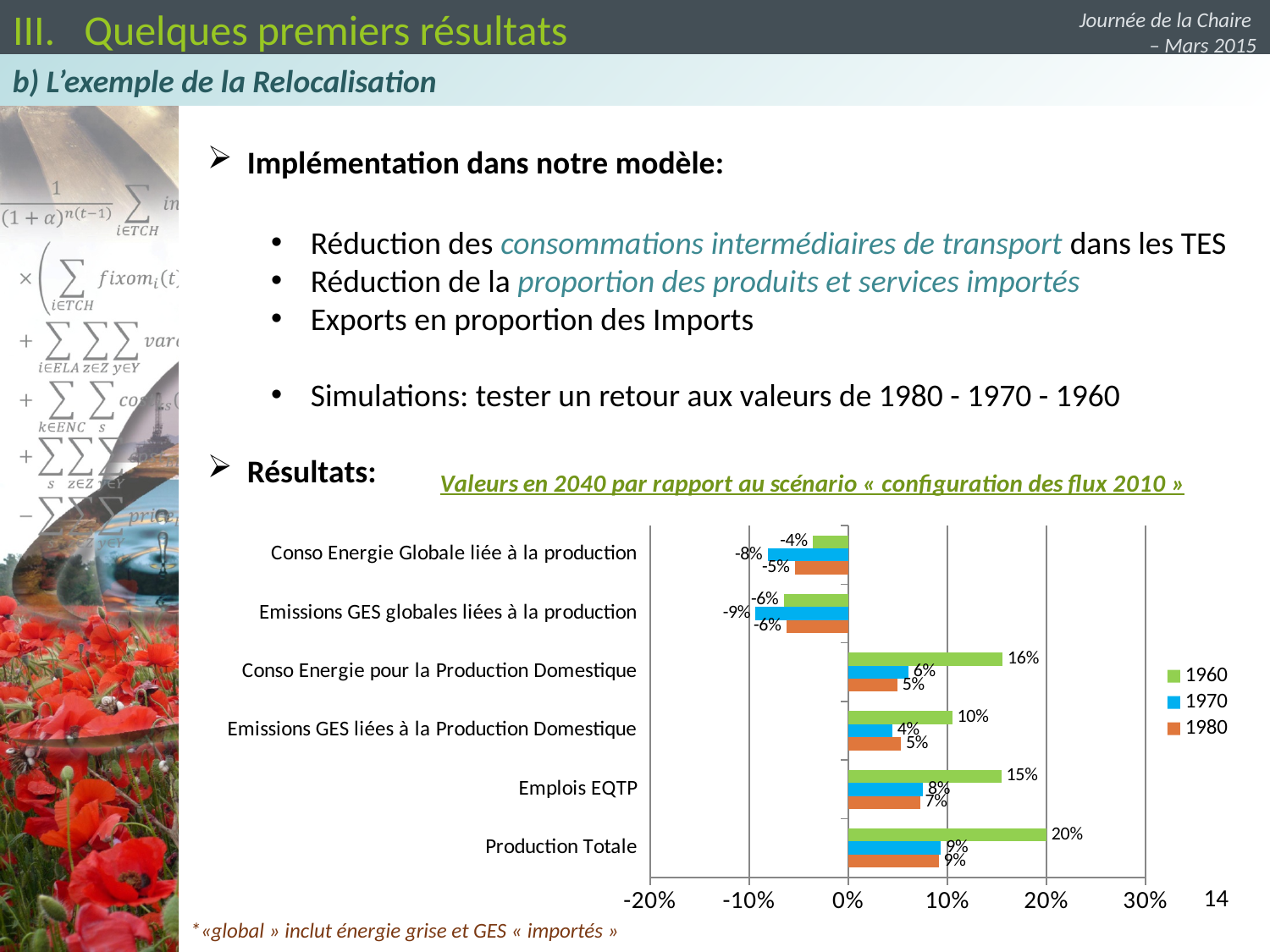
What kind of chart is shown on the slide? bar chart Is the 1960 value for Emplois EQTP greater or less than 10%? greater What is the value for Conso Energie Globale liée à la production in the 1970 series? -8% How many categories are shown on the chart? 6 What is the value for Production Totale in the 1960 series? 20% What is the value for Emplois EQTP in the 1980 series? 7% What is the difference between the 1960 and 1970 values for Conso Energie pour la Production Domestique? 10% How many series does the chart legend list? 3 Which series is shown in green in the chart legend? 1960 Which category has the lowest value in the 1970 series? Emissions GES globales liées à la production Which category has the highest value in the 1960 series? Production Totale For Emissions GES liées à la Production Domestique, which series has the larger value, 1960 or 1980? 1960